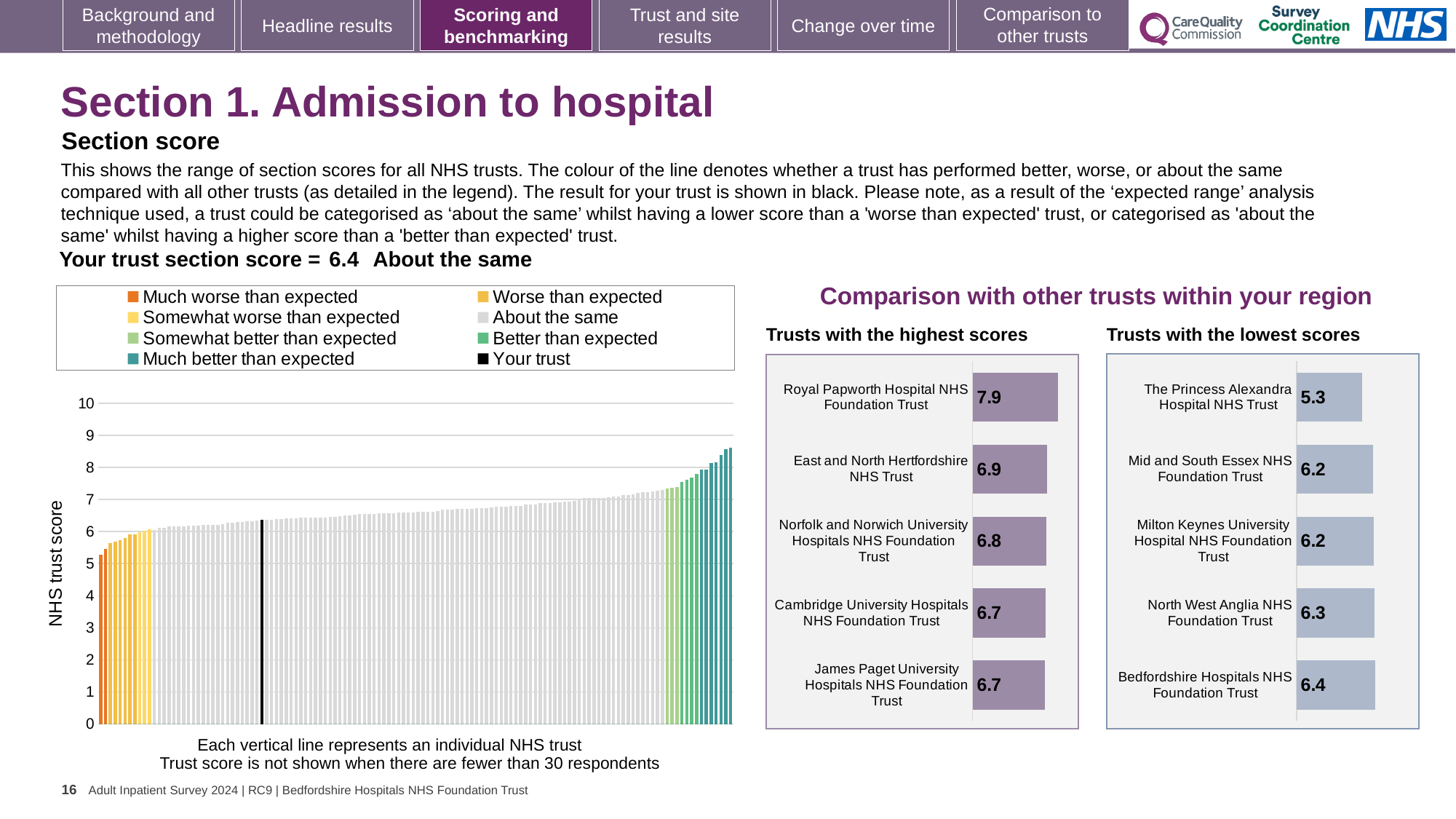
In the 'Trusts with the highest scores' chart, which trust has the highest score? Royal Papworth Hospital NHS Foundation Trust In the large chart on the left, do the trust scores rise or fall from left to right? rise In the large chart on the left, is the value of the tallest bar greater or less than 8? greater In the 'Trusts with the lowest scores' chart, which trust has the lowest score? The Princess Alexandra Hospital NHS Trust In the 'Trusts with the highest scores' chart, what is the score for Royal Papworth Hospital NHS Foundation Trust? 7.9 In the 'Trusts with the highest scores' chart, what is the difference between the scores of Royal Papworth Hospital NHS Foundation Trust and East and North Hertfordshire NHS Trust? 1.0 In the large chart on the left, what is the label on the vertical axis? NHS trust score What kind of chart is the large chart on the left showing NHS trust scores? bar chart In the 'Trusts with the lowest scores' chart, how many trusts are shown? 5 In the 'Trusts with the lowest scores' chart, what is the score for North West Anglia NHS Foundation Trust? 6.3 In the large chart on the left, how many entries does the legend list? 8 In the large chart on the left, what is the section score for your trust (the black bar)? 6.4